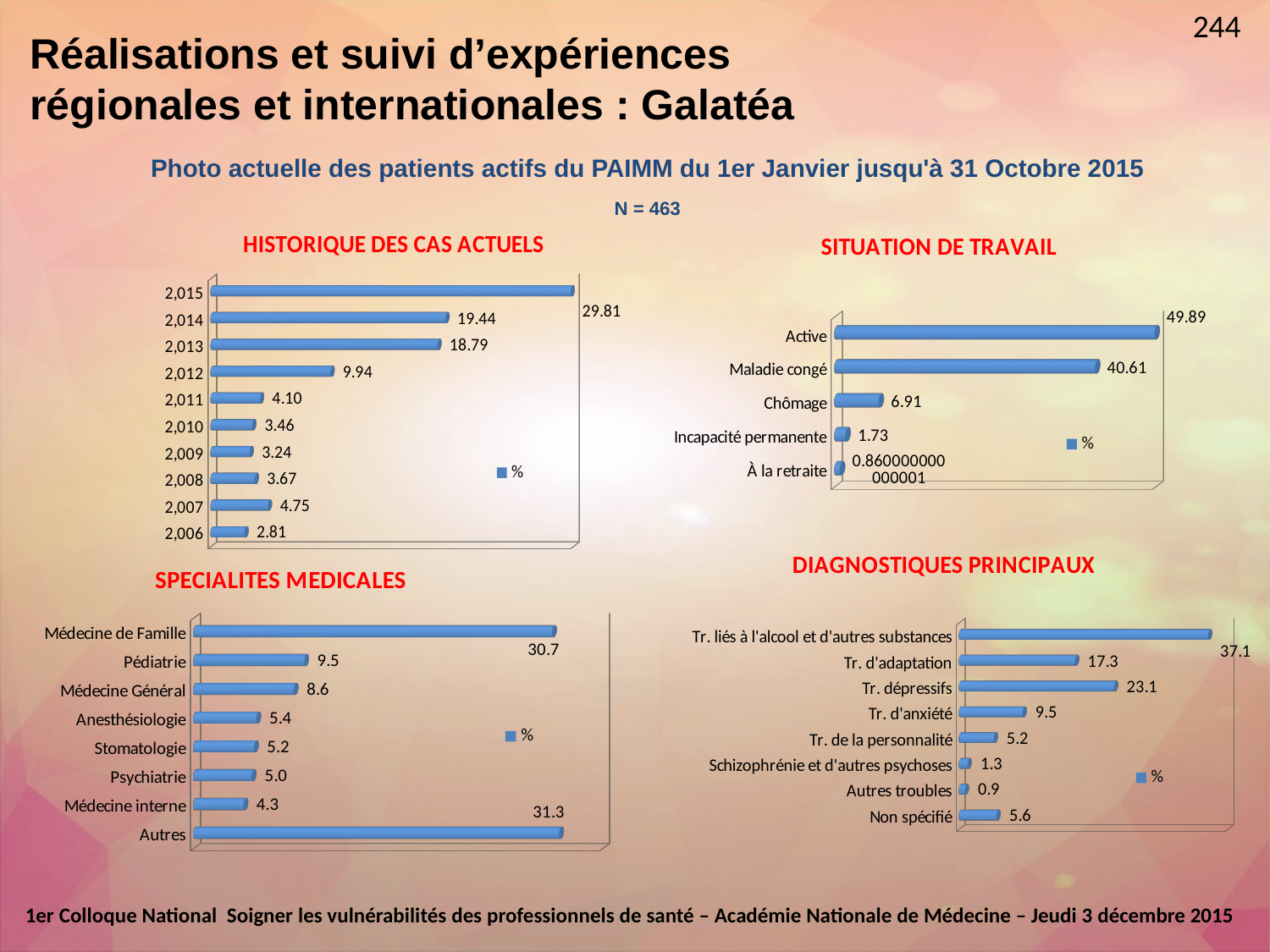
In the 'DIAGNOSTIQUES PRINCIPAUX' chart, which category has the lowest value? Autres troubles In the 'DIAGNOSTIQUES PRINCIPAUX' chart, what is the value for Tr. dépressifs? 23.1 In the 'SPECIALITES MEDICALES' chart, which category has the highest value? Autres In the 'SITUATION DE TRAVAIL' chart, which category has the highest value? Active In the 'HISTORIQUE DES CAS ACTUELS' chart, what is the difference between the values for 2,015 and 2,014? 10.37 In the 'SPECIALITES MEDICALES' chart, which is larger, Médecine Général or Anesthésiologie? Médecine Général In the 'HISTORIQUE DES CAS ACTUELS' chart, what is the value for 2,013? 18.79 In the 'SPECIALITES MEDICALES' chart, what is the value for Pédiatrie? 9.5 In the 'SITUATION DE TRAVAIL' chart, what is the value for Maladie congé? 40.61 In the 'SITUATION DE TRAVAIL' chart, how many categories are shown? 5 In the 'HISTORIQUE DES CAS ACTUELS' chart, which year has the lowest value? 2,006 What type of chart is the 'DIAGNOSTIQUES PRINCIPAUX' chart? Bar chart